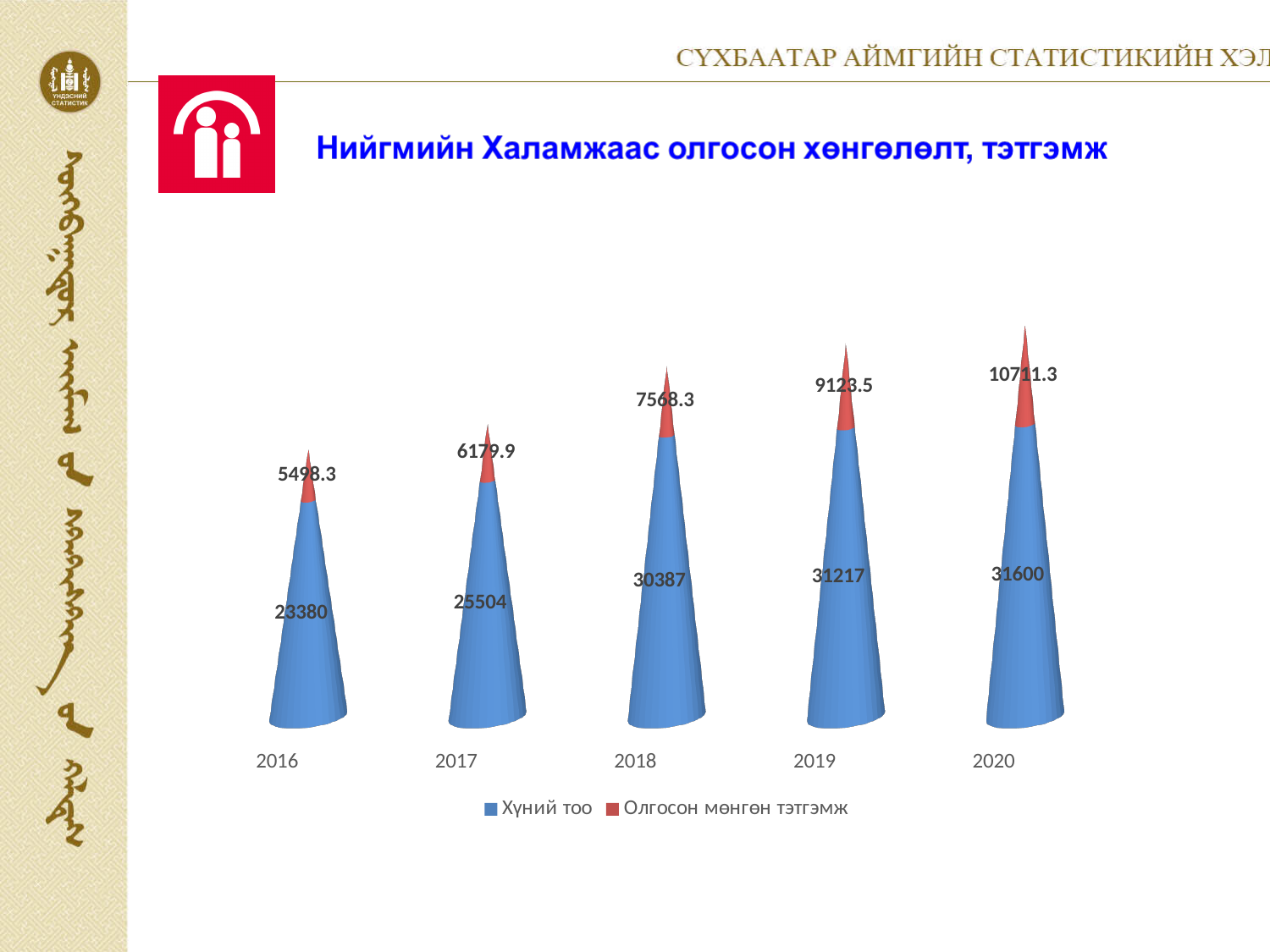
What is the value of Олгосон мөнгөн тэтгэмж for 2019? 9123.5 Which year has the highest value for Олгосон мөнгөн тэтгэмж? 2020 Does the Хүний тоо value rise or fall from 2016 to 2020? rise How many series does the legend list? 2 Which year has the lowest value for Хүний тоо? 2016 Which is larger, the Олгосон мөнгөн тэтгэмж value for 2017 or for 2018? 2018 What is the value of Хүний тоо for 2018? 30387 What is the difference between the Хүний тоо values for 2020 and 2016? 8220 What is the difference between the Олгосон мөнгөн тэтгэмж values for 2020 and 2016? 5213 How many years are shown on the x axis? 5 What is the value of Хүний тоо for 2016? 23380 What is the total of the stacked bar for 2020? 42311.3